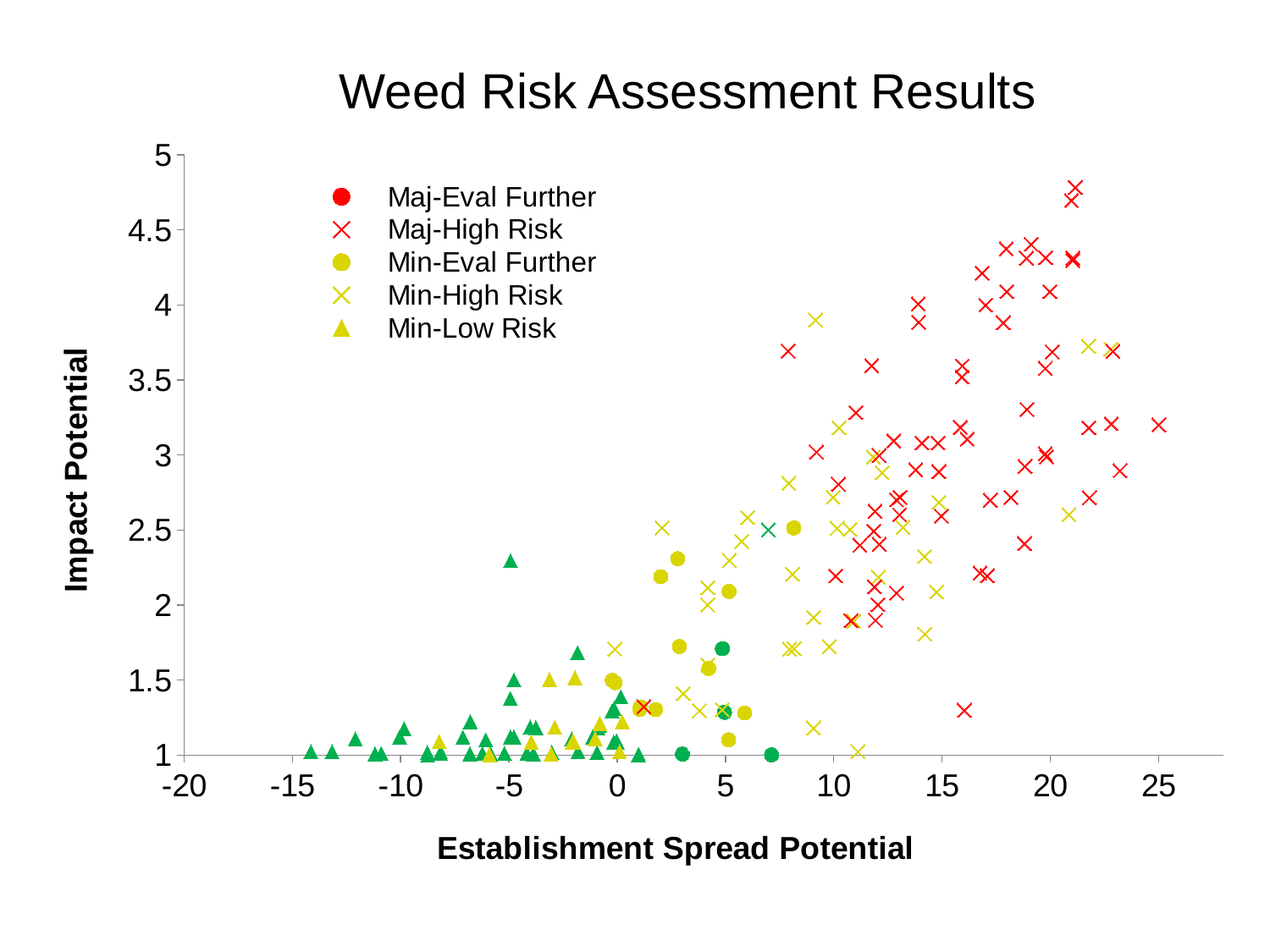
What kind of chart is shown on the slide? scatter chart Which series has the point with the highest Establishment Spread Potential? Maj-High Risk Is the lowest Establishment Spread Potential value plotted greater or less than -10? less What is the label of the horizontal axis? Establishment Spread Potential As Establishment Spread Potential increases along the x axis, does Impact Potential generally rise or fall? rise What is the title of the chart? Weed Risk Assessment Results Is the highest Impact Potential value plotted greater or less than 4.5? greater Which series has the point with the highest Impact Potential? Maj-High Risk How many series does the legend list? 5 Is the highest Establishment Spread Potential value plotted greater or less than 20? greater